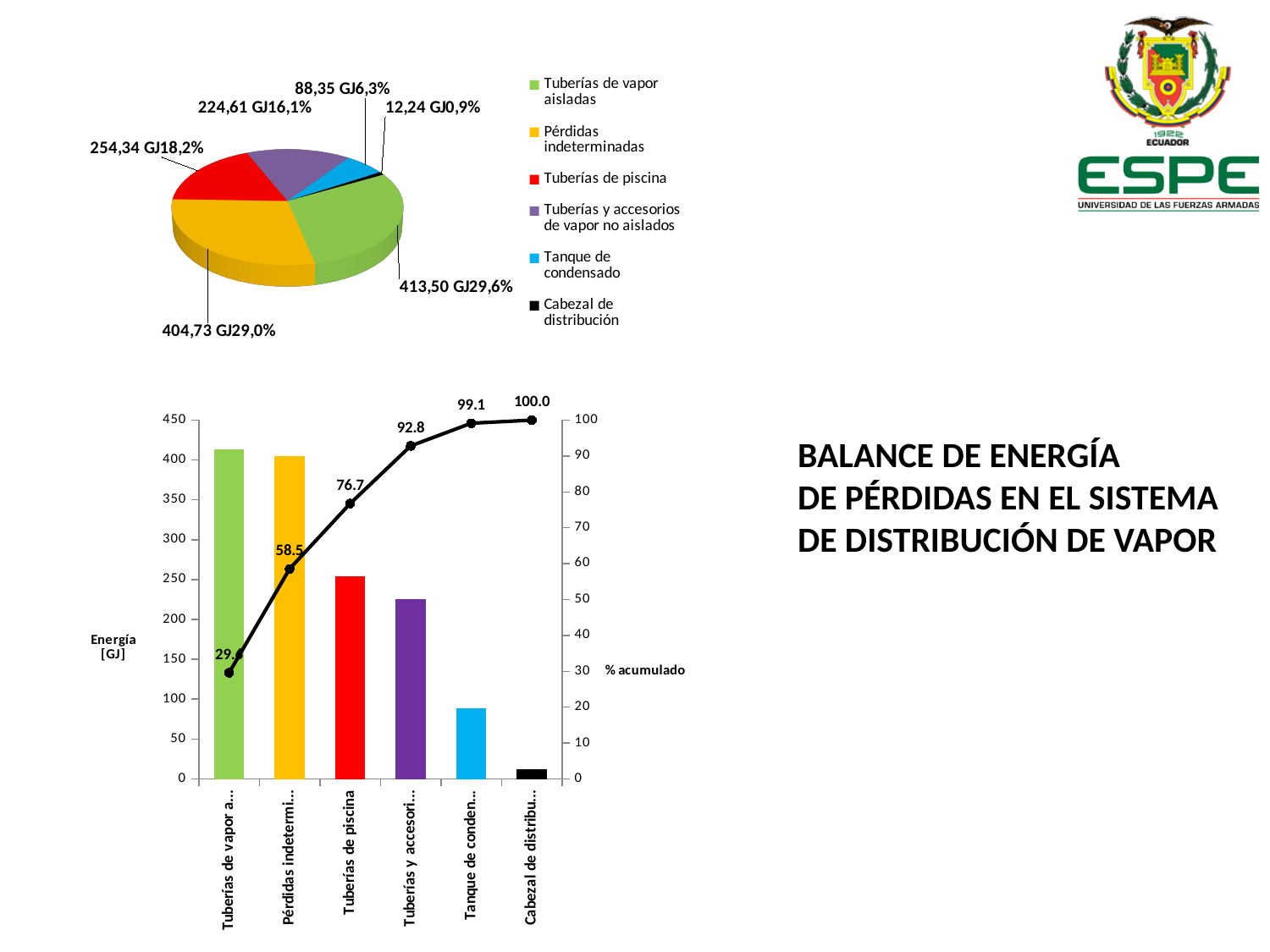
In the bottom chart, which bar is taller: Tuberías de piscina or Tanque de condensado? Tuberías de piscina In the pie chart, what energy value is shown for Tuberías de piscina? 254,34 GJ In the pie chart, what percentage share does Tanque de condensado have? 6,3% In the bottom chart, does the % acumulado line rise or fall from left to right? rises In the bottom chart, what is the cumulative percentage (% acumulado) at Tuberías de piscina? 76.7 In the bottom chart, is the energy bar for Tanque de condensado greater or less than 100 GJ? less How many slices does the pie chart have? 6 In the pie chart, what percentage share does Tuberías y accesorios de vapor no aislados have? 16,1% In the pie chart, which category has the largest slice? Tuberías de vapor aisladas In the pie chart, what is the difference in GJ between Tuberías de vapor aisladas and Pérdidas indeterminadas? 8,77 GJ In the pie chart, which category has the smallest slice? Cabezal de distribución What kind of chart is the bottom chart? Bar chart with a cumulative percentage line